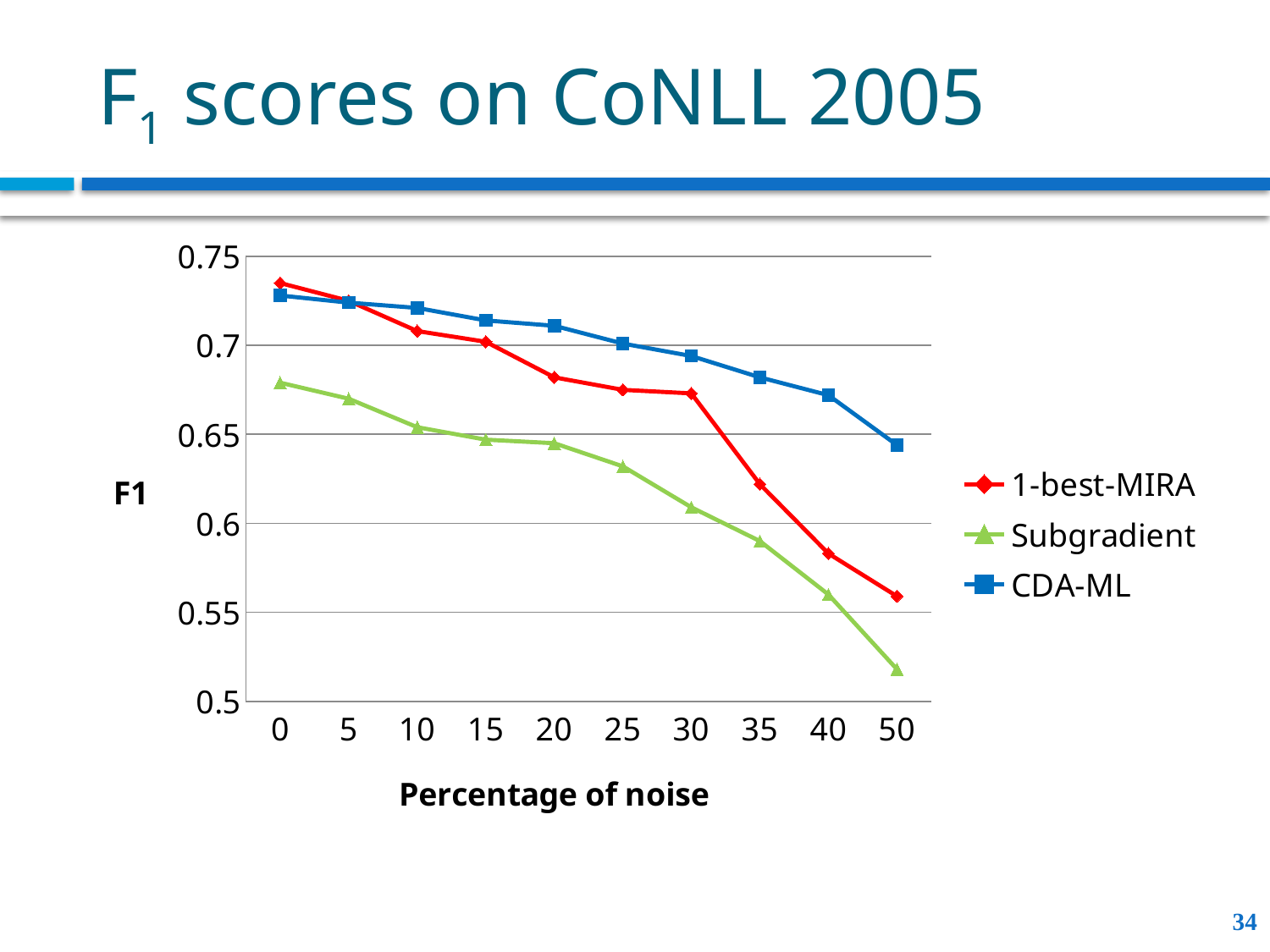
At 20% noise, which has the higher F1 score, 1-best-MIRA or Subgradient? 1-best-MIRA Is the F1 score for Subgradient at 50% noise greater or less than 0.55? less What kind of chart is shown on the slide? line chart Which series has the lowest F1 score at 50% noise? Subgradient How many series does the legend list? 3 Which series has the highest F1 score at 50% noise? CDA-ML Is the F1 score for 1-best-MIRA at 0% noise greater or less than 0.7? greater Do the F1 scores rise or fall as the percentage of noise increases? fall How many percentage-of-noise values are plotted along the x axis? 10 Is the F1 score for 1-best-MIRA at 35% noise greater or less than 0.6? greater What is the label of the x axis? Percentage of noise